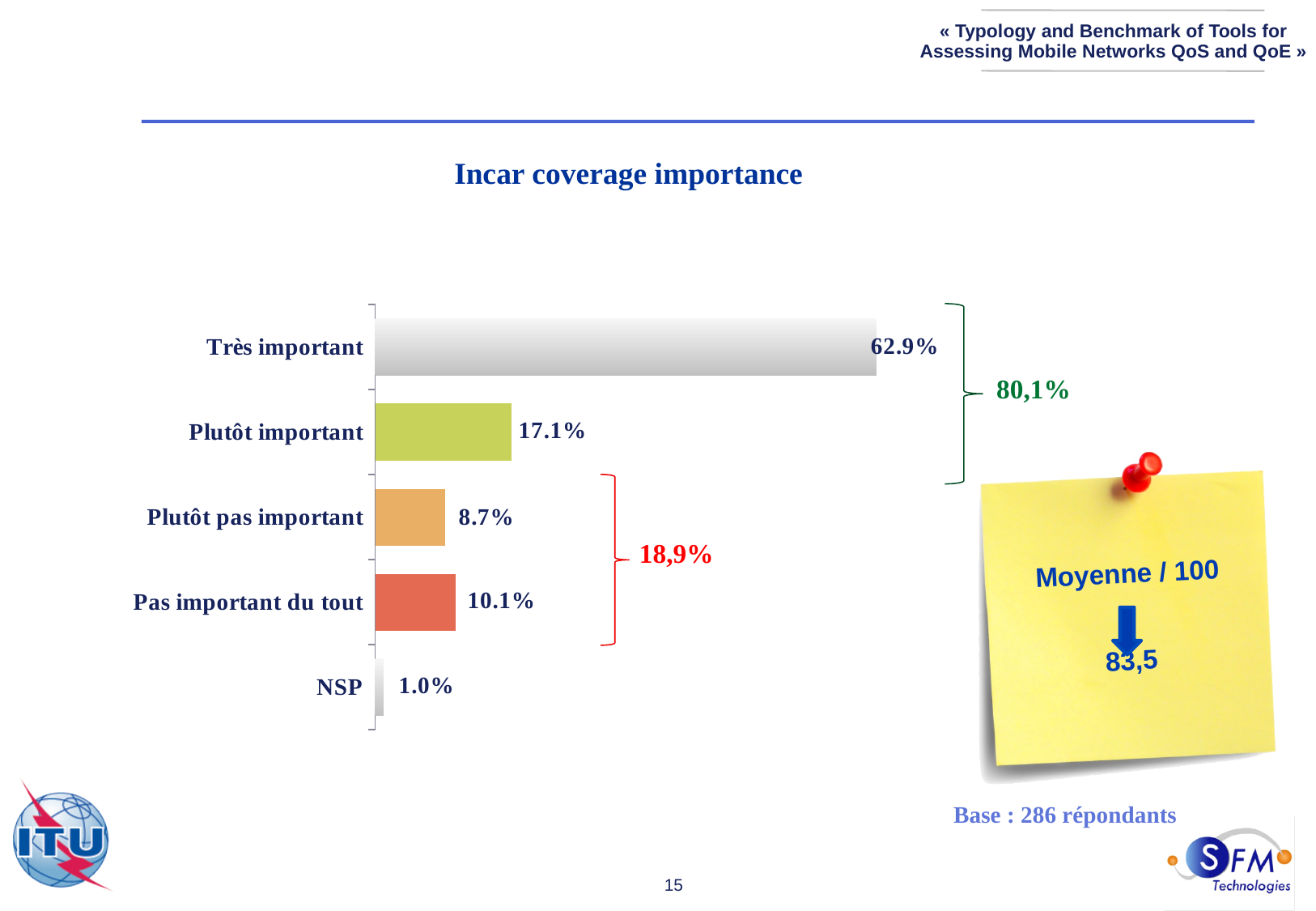
What is the value for "Très important"? 62.9% Which category has the lowest value? NSP What is the value for "Plutôt important"? 17.1% Which category has the highest value? Très important What is the value for "Pas important du tout"? 10.1% What is the value for "NSP"? 1.0% What is the difference between "Très important" and "Plutôt important"? 45.8% What is the difference between "Pas important du tout" and "Plutôt pas important"? 1.4% Which is larger, "Plutôt pas important" or "Pas important du tout"? Pas important du tout What is the title of the chart? Incar coverage importance How many categories are shown in the chart? 5 What kind of chart is shown on the slide? Bar chart